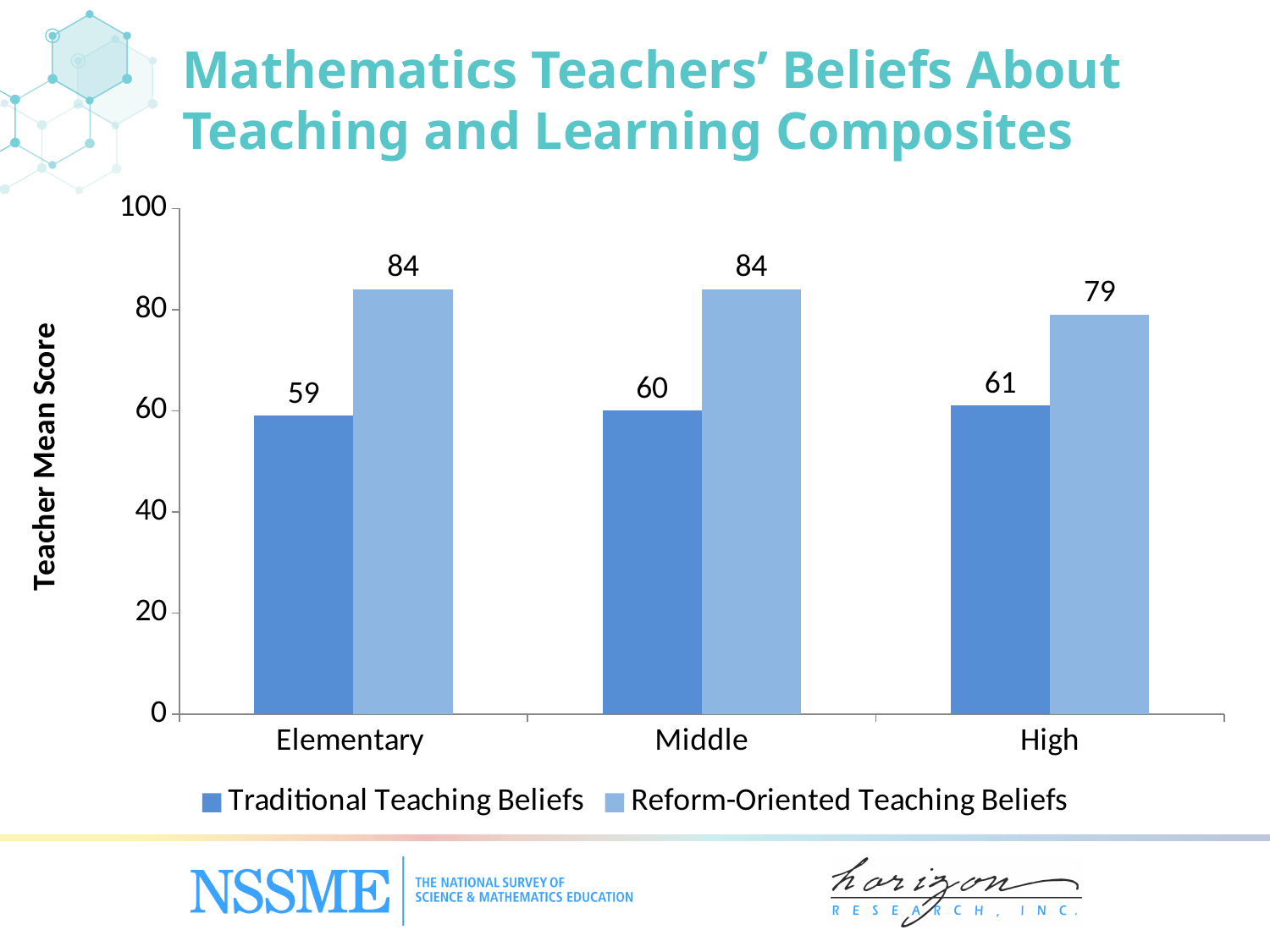
What is the Reform-Oriented Teaching Beliefs mean score for High school teachers? 79 Which grade level has the lowest Reform-Oriented Teaching Beliefs mean score? High Is the Traditional Teaching Beliefs mean score for High school teachers greater or less than 80? less What kind of chart is shown on the slide? Bar chart What is the Traditional Teaching Beliefs mean score for Elementary teachers? 59 How many series does the legend list? 2 What is the Reform-Oriented Teaching Beliefs mean score for Middle school teachers? 84 What is the label of the y axis? Teacher Mean Score Which grade level has the highest Traditional Teaching Beliefs mean score? High How many grade-level categories are shown on the x axis? 3 Which is larger for Middle school teachers: the Traditional Teaching Beliefs score or the Reform-Oriented Teaching Beliefs score? Reform-Oriented Teaching Beliefs What is the difference between the Reform-Oriented and Traditional Teaching Beliefs mean scores for Elementary teachers? 25